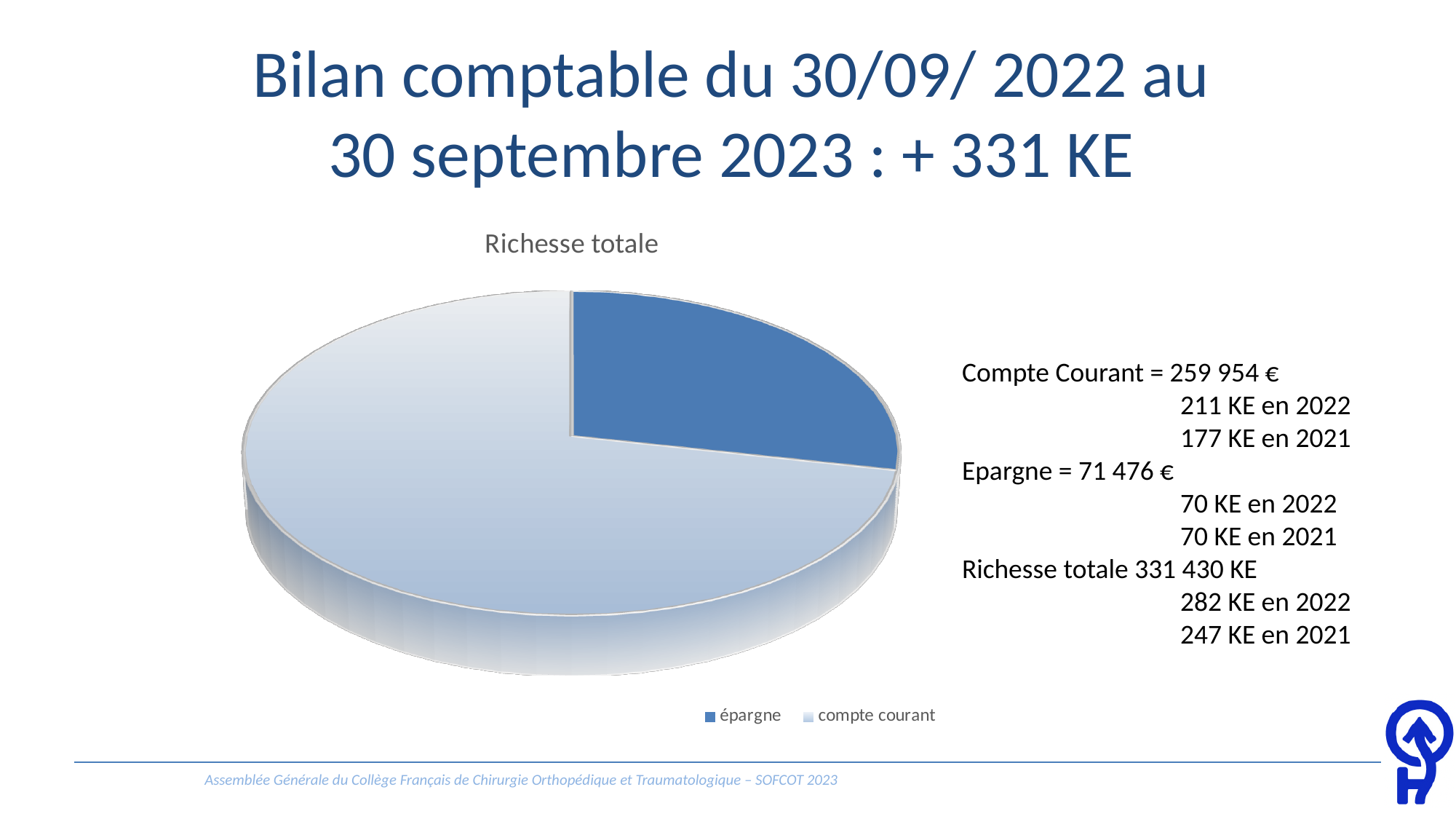
How many slices does the pie chart have? 2 Which slice of the pie chart is the smallest? épargne What is the title of the chart? Richesse totale Which is larger, the épargne slice or the compte courant slice? compte courant How many entries does the chart legend list? 2 What total is given on the slide for Richesse totale? 331 430 KE According to the text next to the chart, what is the value of Epargne? 71 476 € Which legend entry is shown in the darker blue colour? épargne Which slice of the pie chart is the largest? compte courant What is the difference between the Compte Courant value and the Epargne value printed on the slide? 188 478 € According to the text next to the chart, what is the value of Compte Courant? 259 954 € What kind of chart is shown on the slide? pie chart